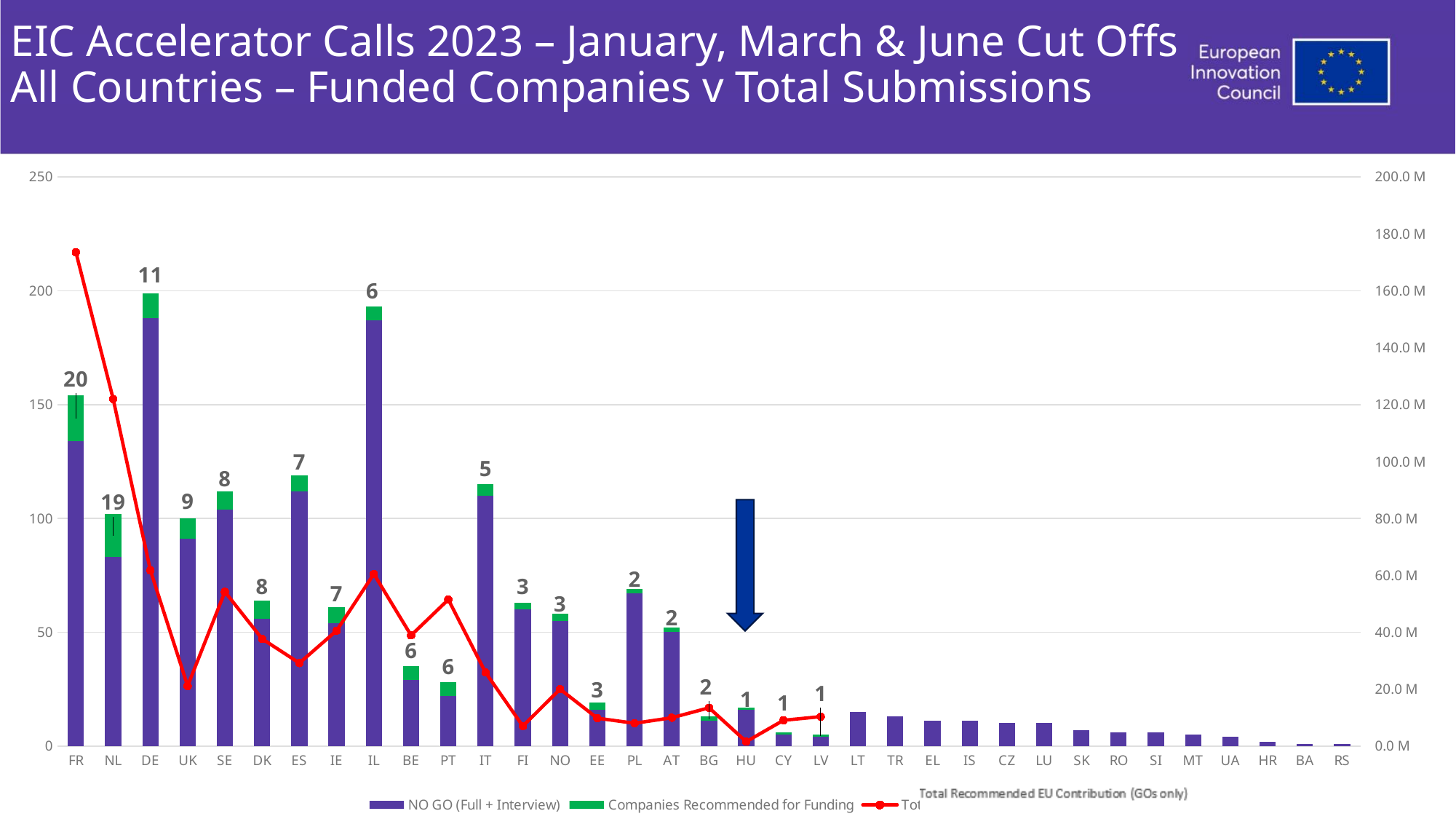
Which has more companies recommended for funding, UK or SE? UK How many companies were recommended for funding for PT? 6 What kind of chart is shown on the slide? Stacked bar chart with a line How many companies were recommended for funding for DE? 11 How many countries are shown on the x axis? 35 How many companies were recommended for funding for FR? 20 Is the total height of the stacked bar for DE greater or less than 150? greater Does the red Total Recommended EU Contribution line rise or fall from FR to UK? fall How many series does the legend list? 3 Is the Total Recommended EU Contribution value for FR greater or less than 160.0 M? greater Which country has the highest number of companies recommended for funding? FR What is the difference between the number of companies recommended for funding for FR and for NL? 1